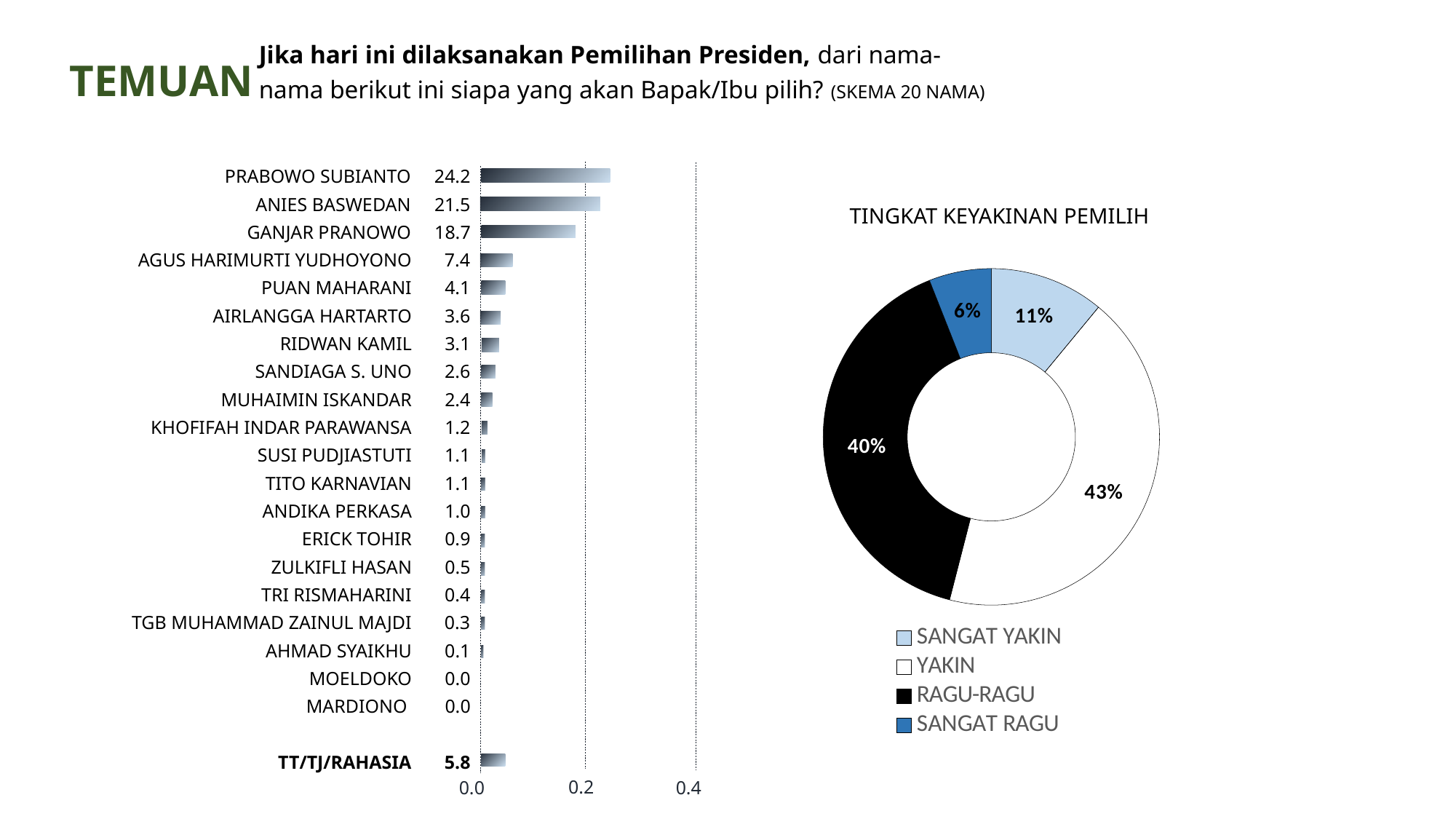
In the bar chart on the left, what is the value for GANJAR PRANOWO? 18.7 In the TINGKAT KEYAKINAN PEMILIH chart, what is the share for YAKIN? 43% In the TINGKAT KEYAKINAN PEMILIH chart, what is the share for SANGAT RAGU? 6% In the TINGKAT KEYAKINAN PEMILIH chart, which category has the smallest share? SANGAT RAGU In the bar chart on the left, what is the value for TT/TJ/RAHASIA? 5.8 In the bar chart on the left, which is larger, the value for PUAN MAHARANI or the value for AIRLANGGA HARTARTO? PUAN MAHARANI In the bar chart on the left, what is the value for PRABOWO SUBIANTO? 24.2 In the bar chart on the left, what kind of chart is shown? bar chart In the bar chart on the left, which candidate has the highest value? PRABOWO SUBIANTO In the bar chart on the left, what is the value for RIDWAN KAMIL? 3.1 In the bar chart on the left, what is the difference between the values for PRABOWO SUBIANTO and ANIES BASWEDAN? 2.7 How many categories does the legend of the TINGKAT KEYAKINAN PEMILIH chart list? 4